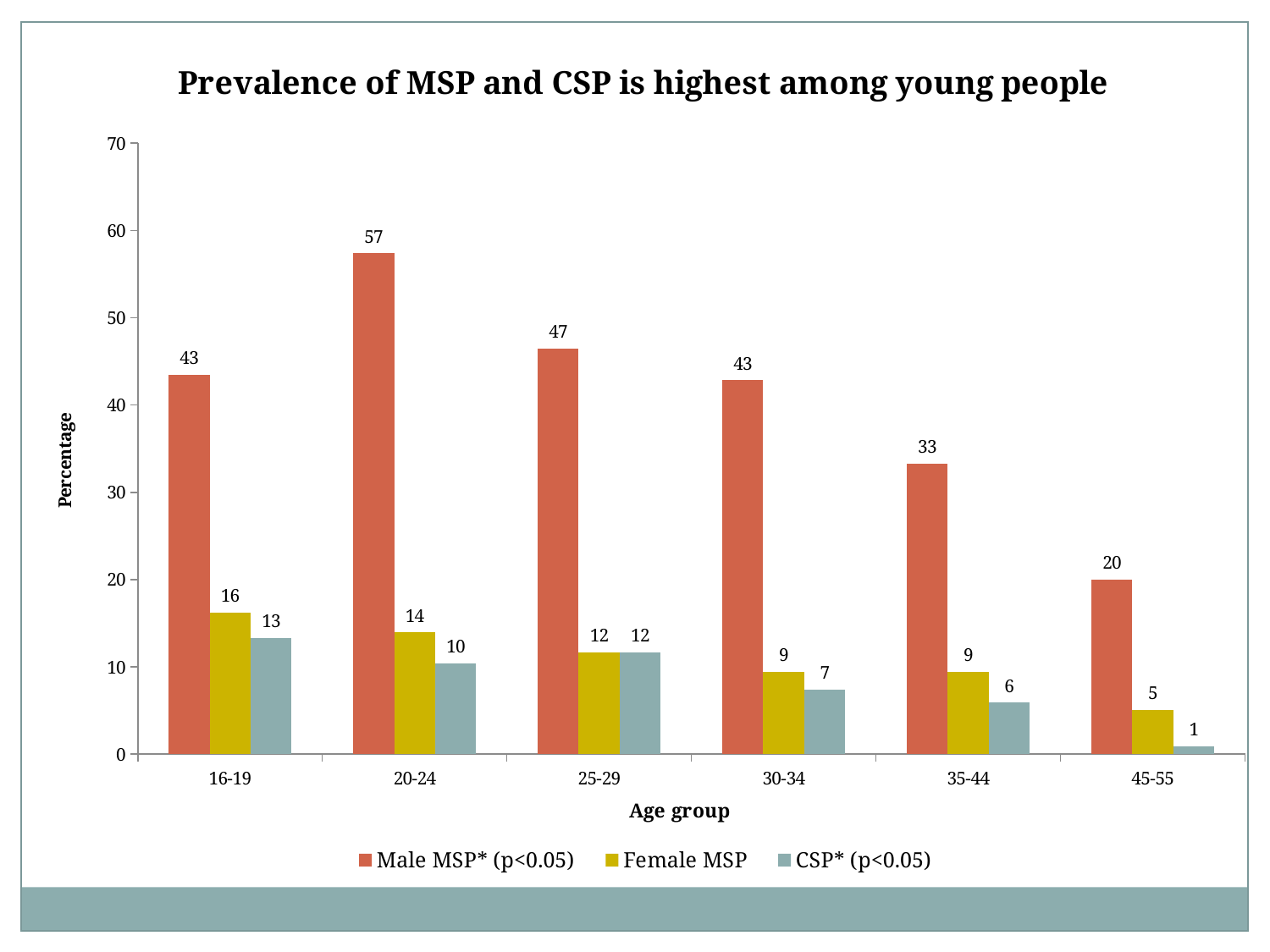
What is the title of the chart? Prevalence of MSP and CSP is highest among young people How many age groups are shown on the x axis? 6 Which age group has the highest Male MSP* (p<0.05) value? 20-24 Which is larger for the 30-34 age group: Female MSP or CSP* (p<0.05)? Female MSP What kind of chart is shown on the slide? bar chart What is the Male MSP* (p<0.05) value for the 20-24 age group? 57 What is the difference between the Male MSP* (p<0.05) values for the 20-24 and 45-55 age groups? 37 What is the CSP* (p<0.05) value for the 45-55 age group? 1 What is the Female MSP value for the 16-19 age group? 16 Which age group has the lowest CSP* (p<0.05) value? 45-55 Is the Male MSP* (p<0.05) value for the 35-44 age group greater or less than 40? less How many series does the legend list? 3